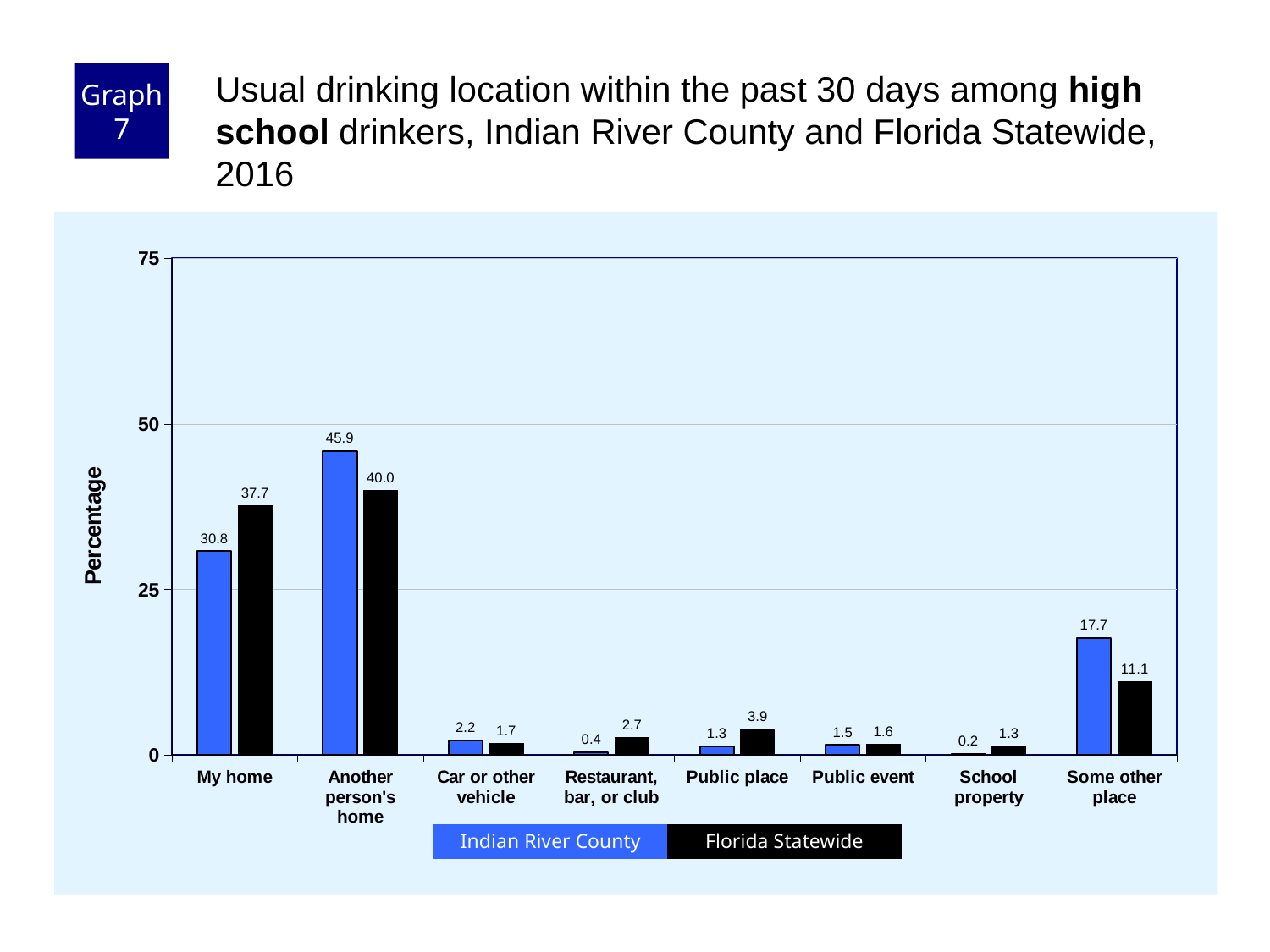
What is the Indian River County value for "Some other place"? 17.7 What kind of chart is shown on the slide? Bar chart What is the Indian River County value for "Another person's home"? 45.9 What is the label of the y axis? Percentage Which category has the highest Florida Statewide value? Another person's home What is the Florida Statewide value for "My home"? 37.7 Is the Indian River County value for "My home" greater or less than 25? greater How many categories are shown on the x axis? 8 What is the difference between the Indian River County and Florida Statewide values for "Some other place"? 6.6 Which category has the lowest Indian River County value? School property How many series does the legend list? 2 Which is larger for "Public place": the Indian River County value or the Florida Statewide value? Florida Statewide